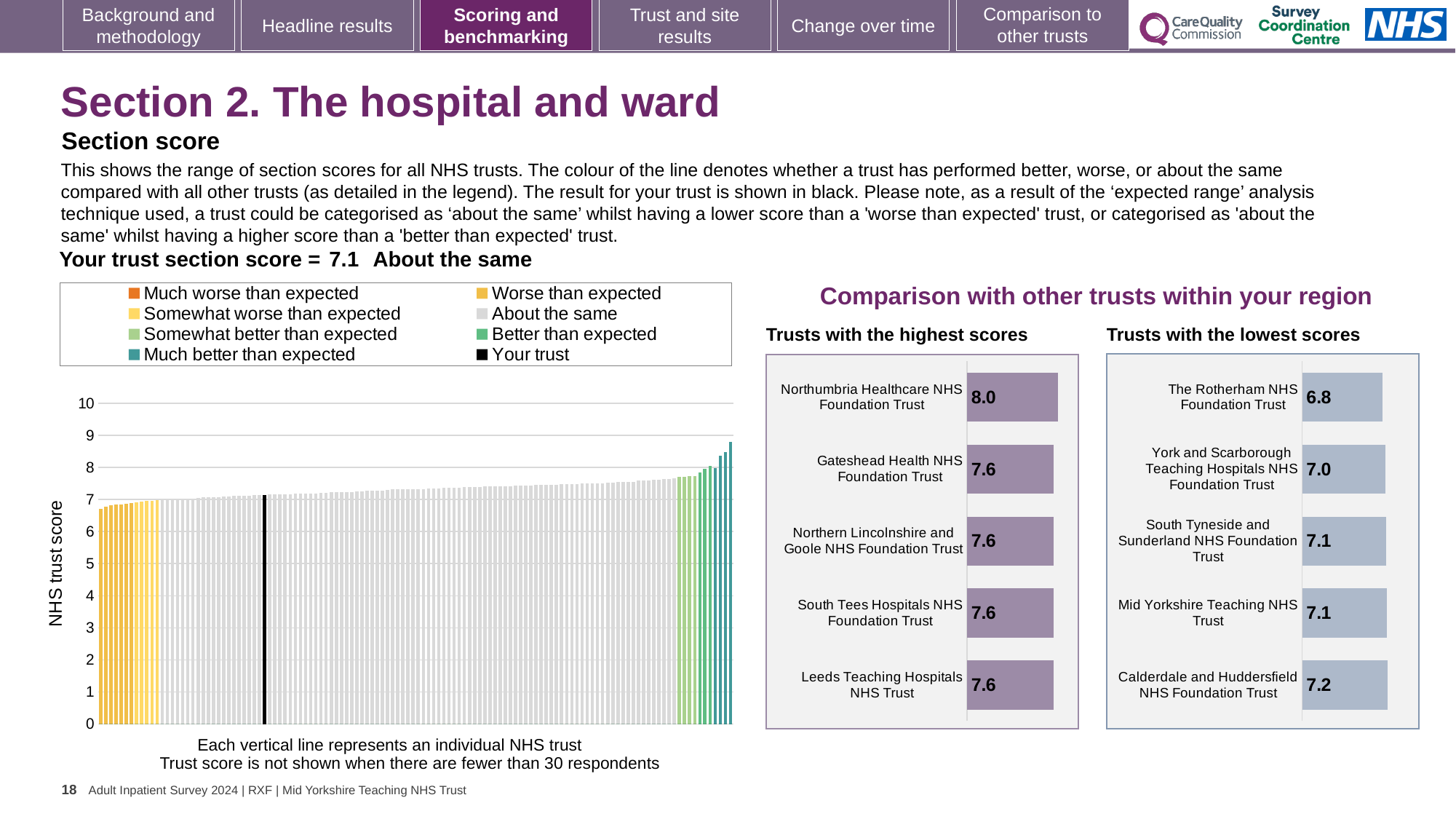
In the 'Trusts with the lowest scores' chart, which trust has the lowest score? The Rotherham NHS Foundation Trust In the 'Trusts with the lowest scores' chart, what is the difference between the scores of Calderdale and Huddersfield NHS Foundation Trust and The Rotherham NHS Foundation Trust? 0.4 What kind of chart is the large 'NHS trust score' chart on the left of the slide? Bar chart In the large 'NHS trust score' chart, is the value of the tallest bar greater or less than 8? greater In the 'Trusts with the lowest scores' chart, what is the score for The Rotherham NHS Foundation Trust? 6.8 In the 'Trusts with the lowest scores' chart, what is the score for York and Scarborough Teaching Hospitals NHS Foundation Trust? 7.0 In the 'Trusts with the highest scores' chart, what is the score for Northumbria Healthcare NHS Foundation Trust? 8.0 In the 'Trusts with the highest scores' chart, which has the larger score: Northumbria Healthcare NHS Foundation Trust or Leeds Teaching Hospitals NHS Trust? Northumbria Healthcare NHS Foundation Trust How many entries does the legend of the large 'NHS trust score' chart list? 8 In the 'Trusts with the highest scores' chart, what is the difference between the scores of Northumbria Healthcare NHS Foundation Trust and Gateshead Health NHS Foundation Trust? 0.4 In the 'Trusts with the highest scores' chart, which trust has the highest score? Northumbria Healthcare NHS Foundation Trust How many trusts are shown in the 'Trusts with the highest scores' chart? 5